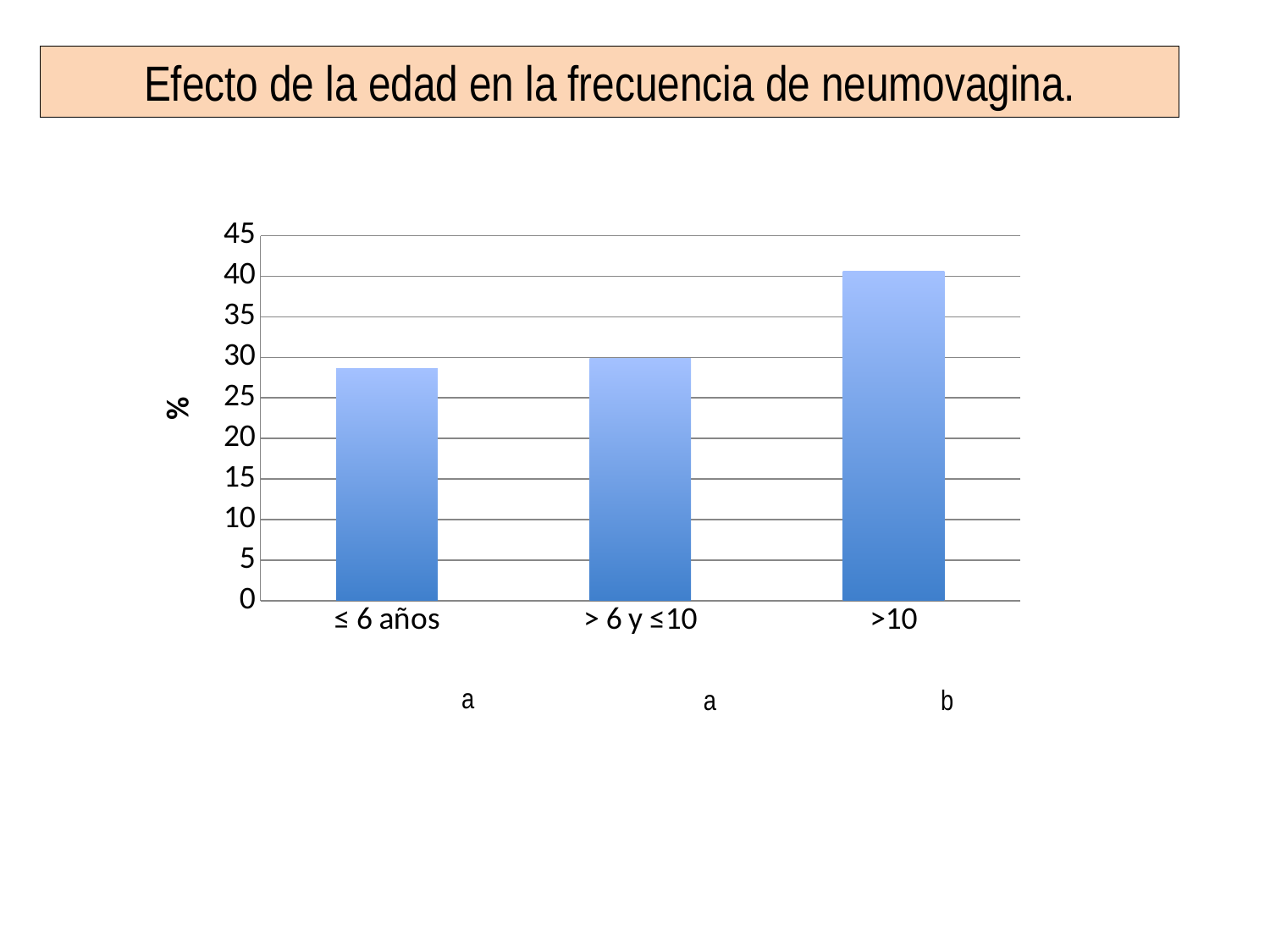
Which is larger, the value for "> 6 y ≤10" or the value for ">10"? >10 What is the label on the vertical axis of the chart? % Is the value for "≤ 6 años" greater or less than 35? less What kind of chart is shown on the slide? bar chart What is the title shown above the chart on the slide? Efecto de la edad en la frecuencia de neumovagina. Is the value for "> 6 y ≤10" greater or less than 35? less Do the values rise or fall as age increases along the x axis? rise How many age categories are plotted on the chart? 3 Is the value for ">10" greater or less than 35? greater Which is larger, the value for "≤ 6 años" or the value for ">10"? >10 Which age category has the highest frequency of neumovagina? >10